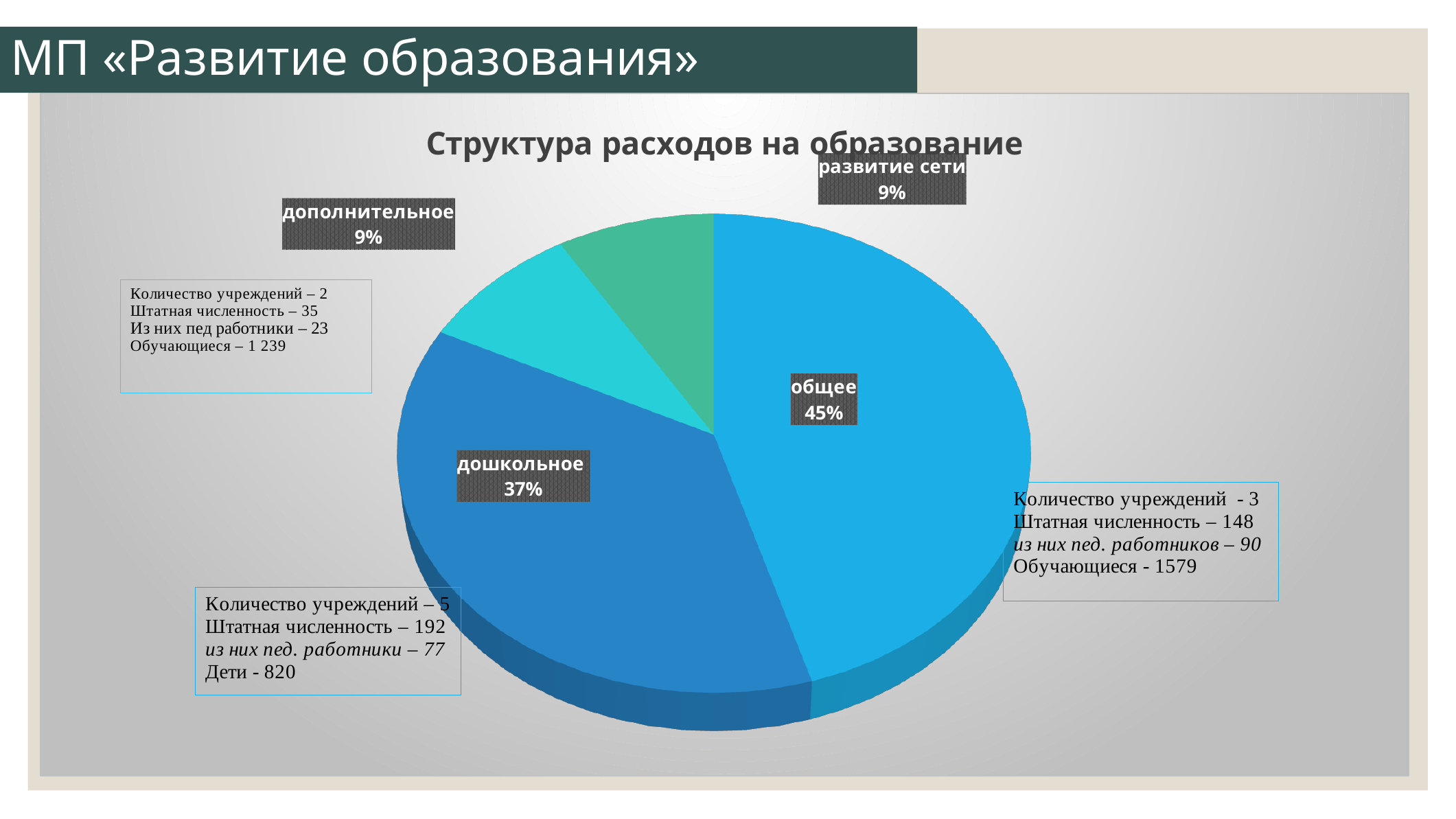
What share of the pie does the "общее" slice represent? 45% What share of the pie does the "дошкольное" slice represent? 37% Which slice of the pie is the largest? общее What share of the pie does the "дополнительное" slice represent? 9% What is the difference in percentage points between the "общее" and "дошкольное" slices? 8 How many slices does the pie chart have? 4 Which two slices of the pie have the same share? дополнительное and развитие сети What is the title of the chart? Структура расходов на образование What type of chart is shown on the slide? Pie chart Which is larger, the "дошкольное" slice or the "дополнительное" slice? дошкольное What is the combined share of the "дополнительное" and "развитие сети" slices? 18%